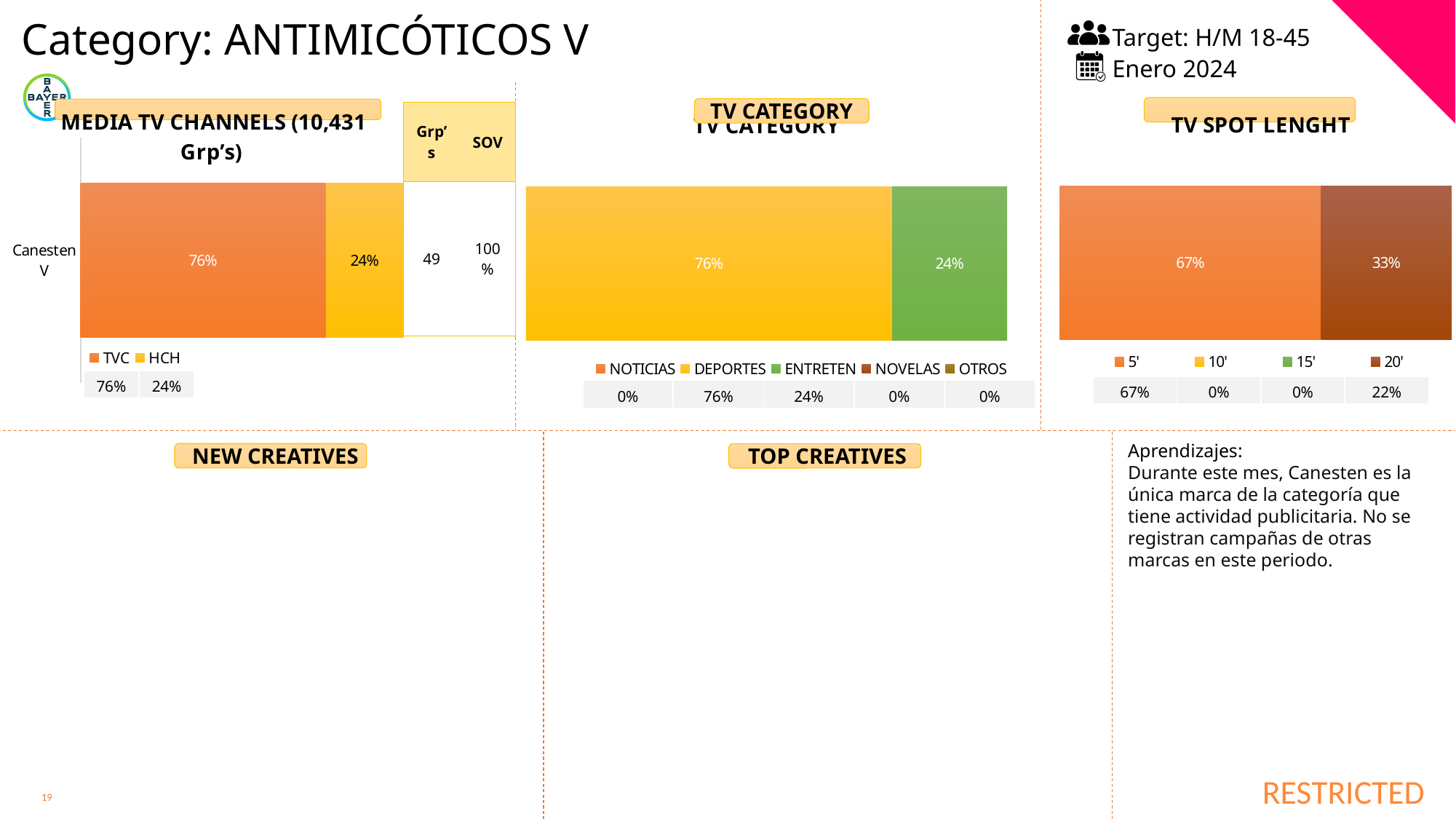
In the MEDIA TV CHANNELS chart, what share does HCH have for Canesten V? 24% In the TV SPOT LENGHT chart, what share does the 10' spot length have? 0% In the TV CATEGORY chart, which category has the highest share? DEPORTES In the MEDIA TV CHANNELS chart, what share does TVC have for Canesten V? 76% In the TV CATEGORY chart, how many series does the legend list? 5 In the TV CATEGORY chart, what share does DEPORTES have? 76% In the MEDIA TV CHANNELS chart, which channel has the larger share, TVC or HCH? TVC In the MEDIA TV CHANNELS chart, how many series does the legend list? 2 In the MEDIA TV CHANNELS chart, what is the difference between the TVC and HCH shares? 52% In the TV CATEGORY chart, what share does ENTRETEN have? 24% What kind of chart is the TV CATEGORY chart? Stacked bar chart In the TV SPOT LENGHT chart, what share does the 5' spot length have? 67%